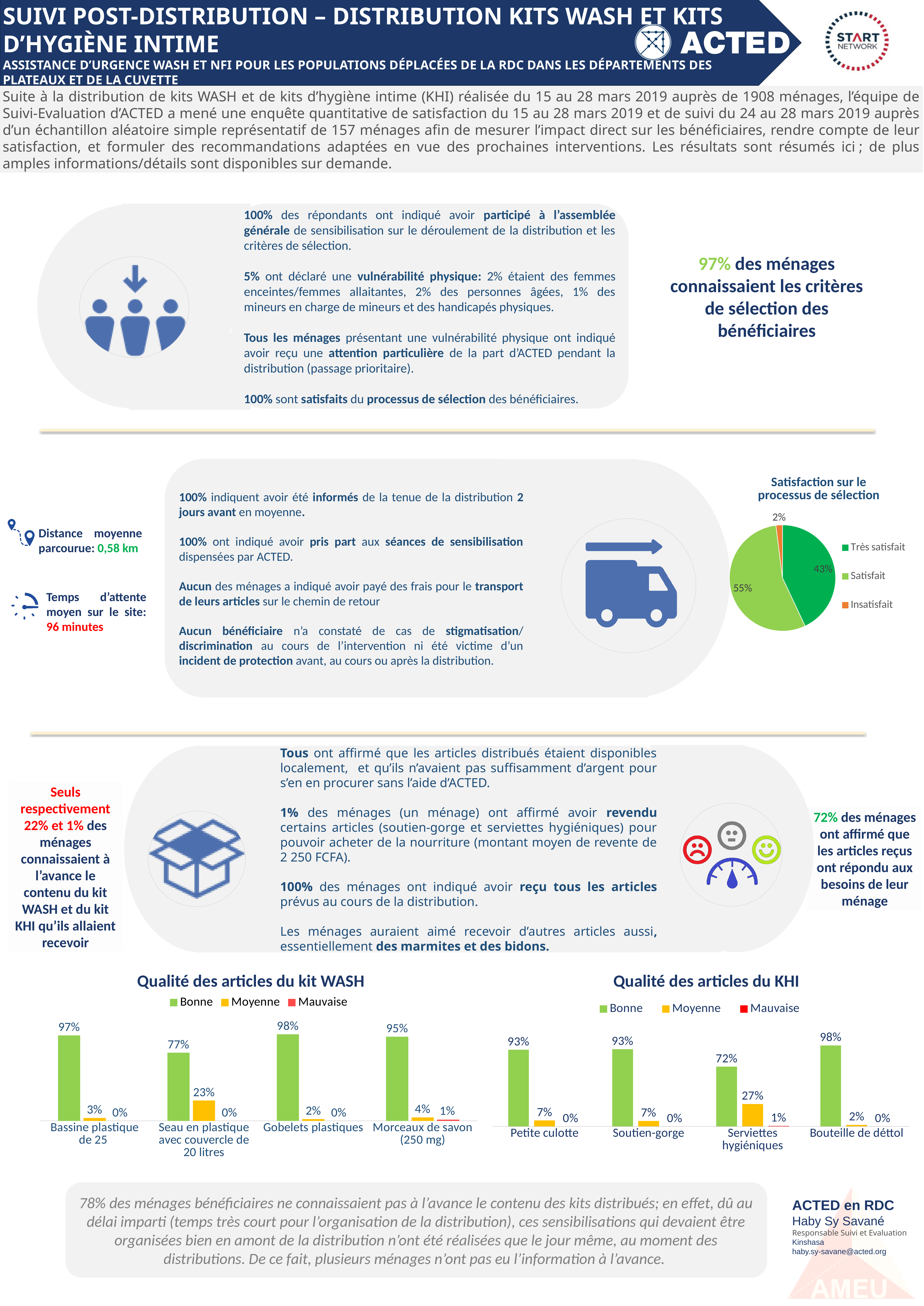
In the 'Qualité des articles du kit WASH' chart, what is the difference between the 'Moyenne' values for 'Seau en plastique avec couvercle de 20 litres' and 'Bassine plastique de 25'? 20% In the 'Qualité des articles du KHI' chart, which article has the lowest 'Bonne' value? Serviettes hygiéniques What type of chart is 'Qualité des articles du KHI'? Bar chart In the 'Qualité des articles du kit WASH' chart, what is the 'Bonne' value for 'Seau en plastique avec couvercle de 20 litres'? 77% In the 'Satisfaction sur le processus de sélection' pie chart, what share is 'Insatisfait'? 2% How many slices does the 'Satisfaction sur le processus de sélection' pie chart have? 3 In the 'Qualité des articles du KHI' chart, what is the 'Moyenne' value for 'Serviettes hygiéniques'? 27% In the 'Satisfaction sur le processus de sélection' pie chart, which slice is the largest? Satisfait In the 'Qualité des articles du kit WASH' chart, which article has the highest 'Bonne' value? Gobelets plastiques How many series does the legend of the 'Qualité des articles du kit WASH' chart list? 3 In the 'Satisfaction sur le processus de sélection' pie chart, what share is 'Satisfait'? 55% What type of chart is 'Satisfaction sur le processus de sélection'? Pie chart